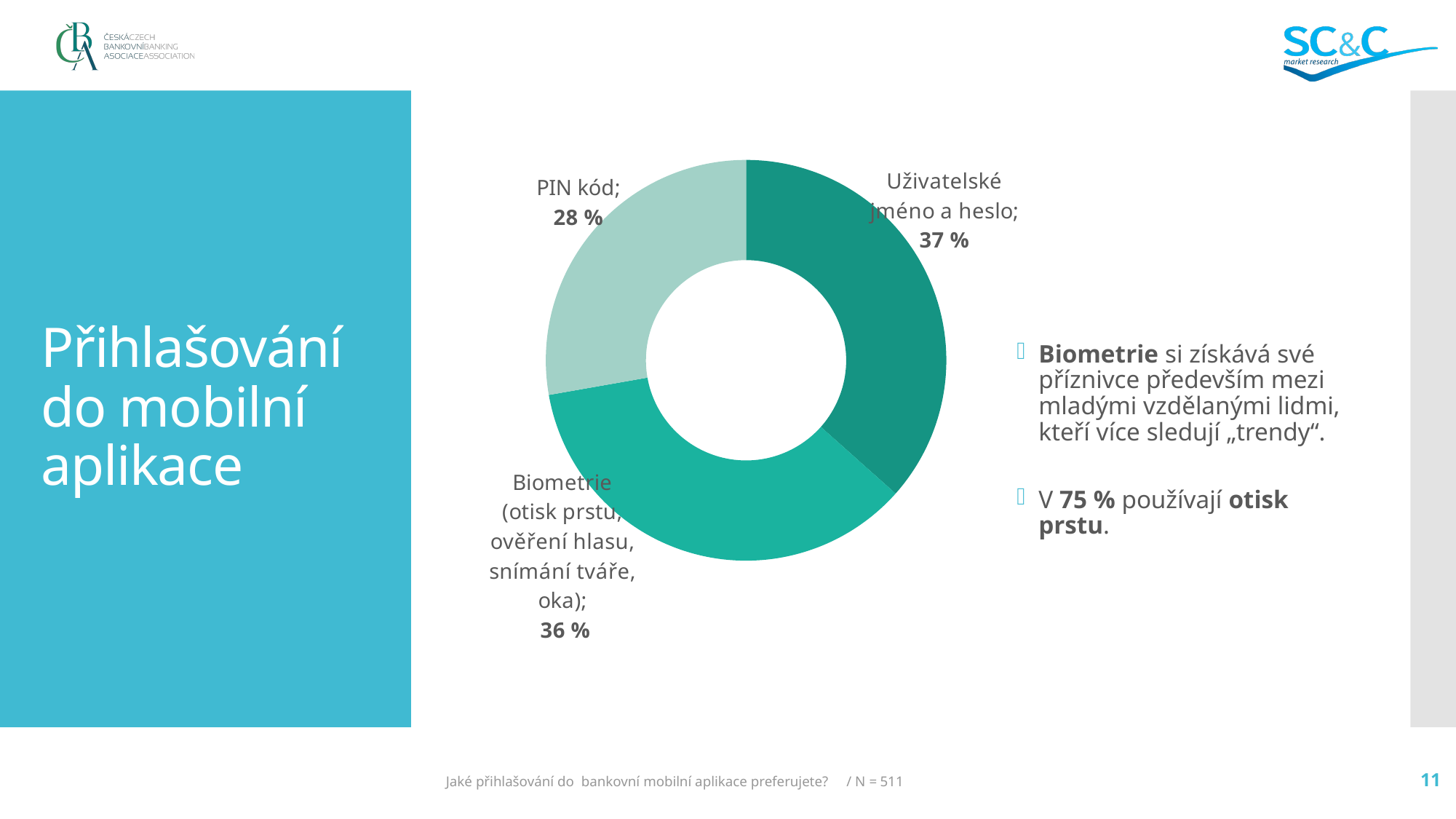
Which category has the highest share? Uživatelské jméno a heslo How many categories does the pie chart show? 3 What type of chart is shown on the slide? doughnut chart What is the title of the slide? Přihlašování do mobilní aplikace What is the value for Uživatelské jméno a heslo? 37 % What is the difference between the share for Biometrie and the share for PIN kód? 8 % What is the sample size (N) stated at the bottom of the slide? N = 511 What is the difference between the share for Uživatelské jméno a heslo and the share for PIN kód? 9 % What is the value for Biometrie (otisk prstu, ověření hlasu, snímání tváře, oka)? 36 % What is the value for PIN kód? 28 % Which category has the lowest share? PIN kód Which is larger, the share for Biometrie or the share for PIN kód? Biometrie